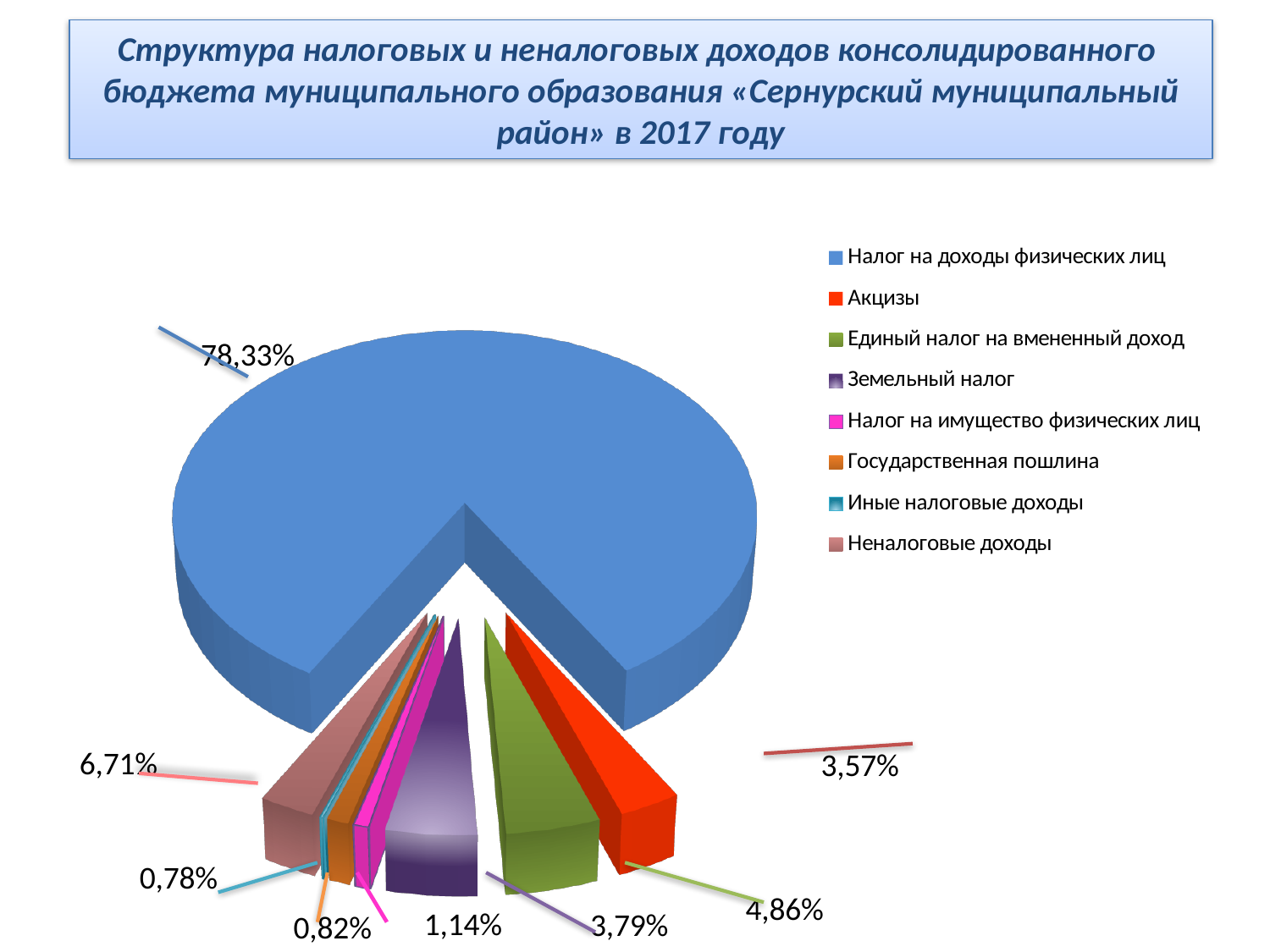
What is the value shown for Неналоговые доходы? 6,71% What share of the pie does Налог на доходы физических лиц have? 78,33% How many categories does the legend list? 8 What is the value shown for Единый налог на вмененный доход? 4,86% Which category has the smallest slice of the pie? Иные налоговые доходы What is the value shown for Акцизы? 3,57% Which category has the largest slice of the pie? Налог на доходы физических лиц What is the difference between the values for Неналоговые доходы and Единый налог на вмененный доход? 1,85% Which colour represents Государственная пошлина in the chart? orange What is the value shown for Земельный налог? 3,79% Which is larger, Единый налог на вмененный доход or Акцизы? Единый налог на вмененный доход What kind of chart is shown on the slide? pie chart